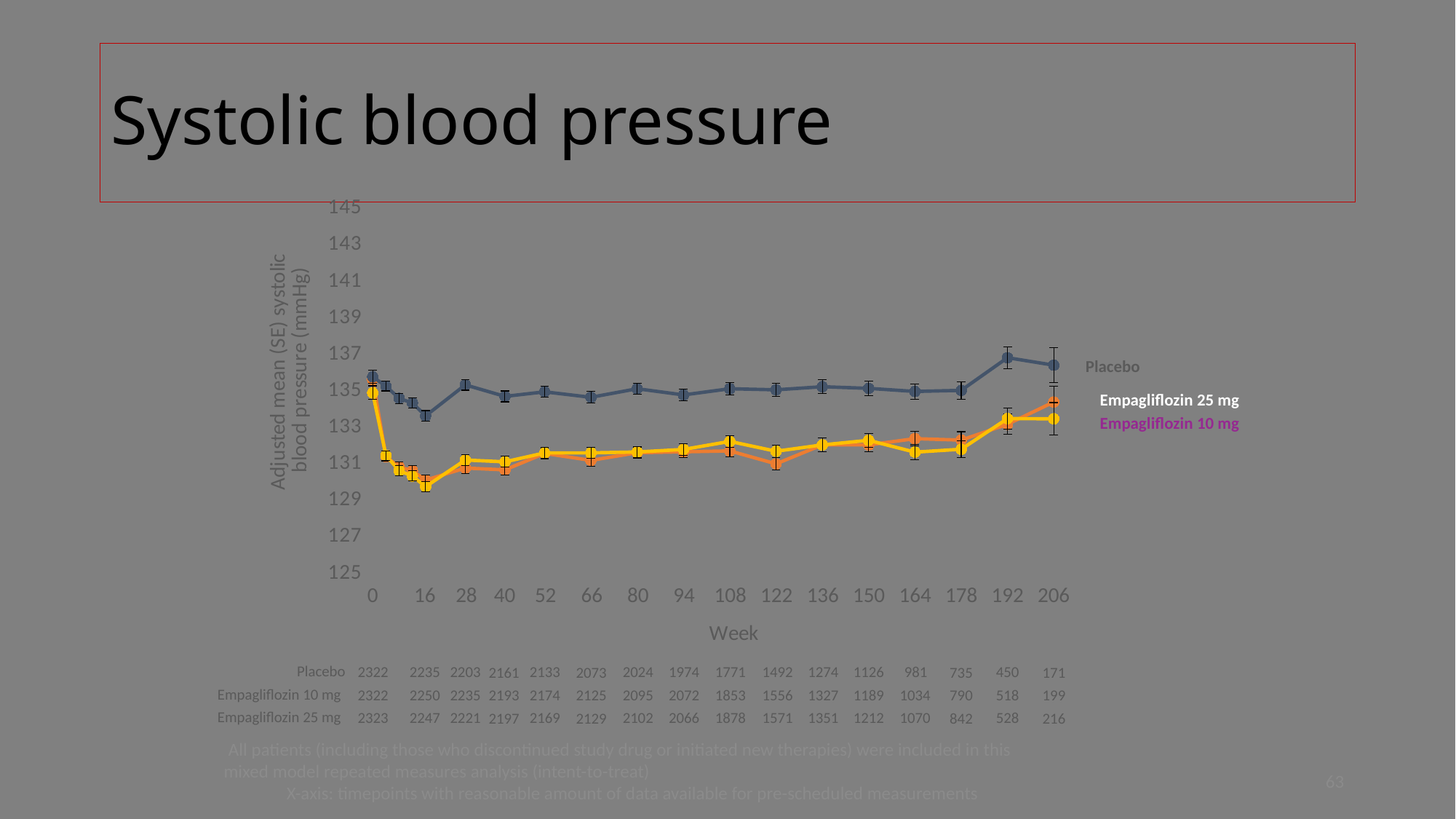
Which series has the highest value at week 206? Placebo At week 52, which is larger: the Placebo value or the Empagliflozin 25 mg value? Placebo According to the patient numbers below the chart, how many Empagliflozin 25 mg patients were there at week 206? 216 What is the label of the x axis? Week Does the Empagliflozin 10 mg line rise or fall between week 0 and week 16? Fall Is the Placebo value at week 192 greater or less than 135? greater What kind of chart is shown on the slide? Line chart How many series are plotted in the chart? 3 Does the Placebo line rise or fall between week 178 and week 192? Rise How many week timepoints are shown on the x axis? 16 According to the patient numbers below the chart, how many Placebo patients were there at week 0? 2322 Is the Empagliflozin 10 mg value at week 16 greater or less than 131? less